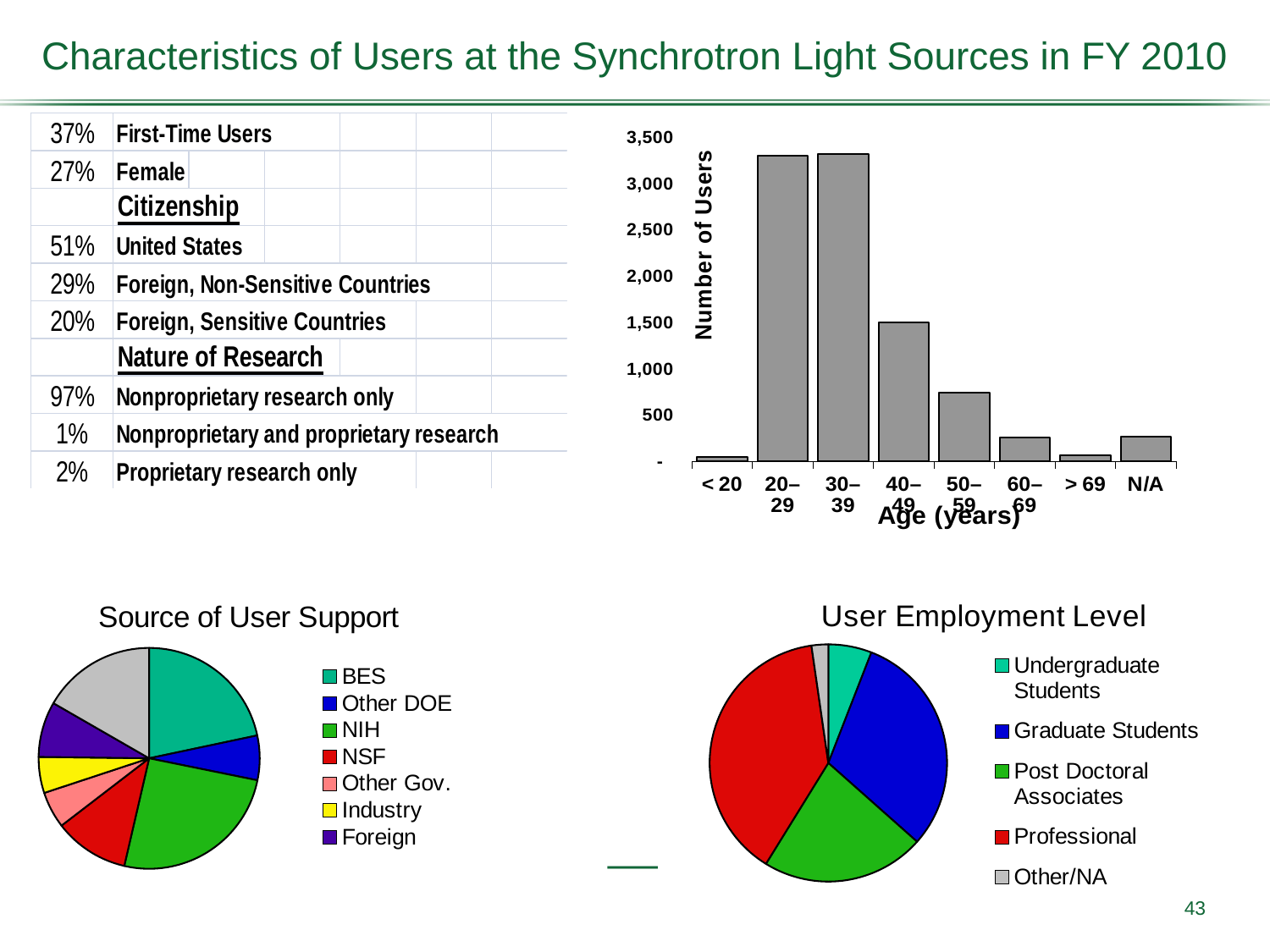
In the bar chart of Number of Users by Age (years), is the value for the 40–49 age group greater or less than 1,000? greater In the User Employment Level chart, which category has the largest slice? Professional In the bar chart of Number of Users by Age (years), do the values rise or fall from the 30–39 group to the > 69 group? fall What kind of chart is the Number of Users by Age (years) chart at the top right of the slide? bar chart In the bar chart of Number of Users by Age (years), is the value for the 50–59 age group greater or less than 1,000? less In the bar chart of Number of Users by Age (years), is the value for the 60–69 age group greater or less than 500? less In the bar chart of Number of Users by Age (years), which is larger, the value for 40–49 or the value for 50–59? 40–49 In the User Employment Level chart, which slice is larger, Graduate Students or Undergraduate Students? Graduate Students How many entries does the legend of the Source of User Support chart list? 7 In the bar chart of Number of Users by Age (years), how many age categories are shown on the x axis? 8 In the User Employment Level chart, which category has the smallest slice? Other/NA